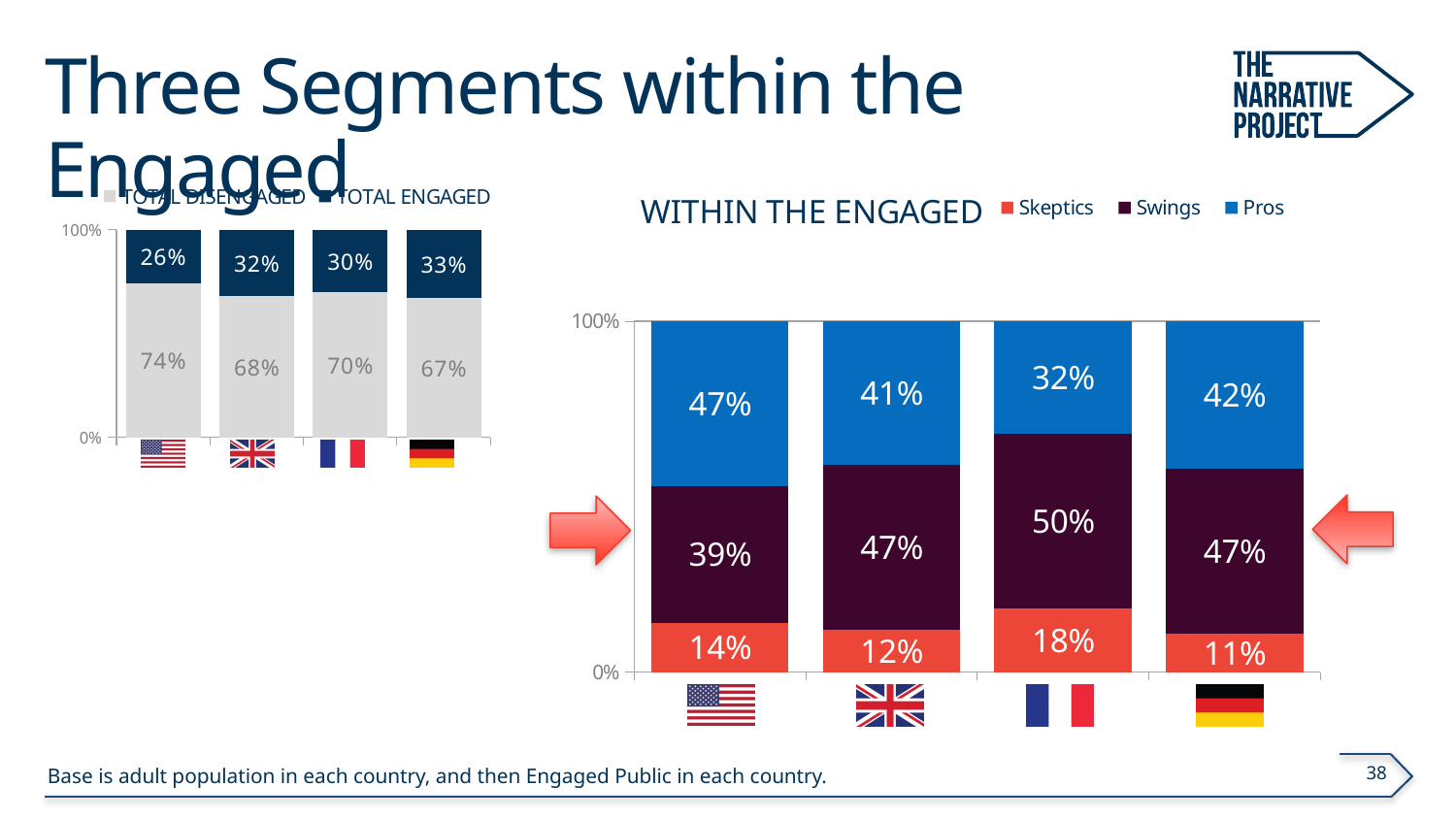
In the 'WITHIN THE ENGAGED' chart, what is the difference between the Pros values for the US and France bars? 15% In the left chart, which country's bar has the highest TOTAL DISENGAGED value? United States In the 'WITHIN THE ENGAGED' chart, what is the Skeptics value for the bar with the French flag? 18% In the 'WITHIN THE ENGAGED' chart, which country's bar has the lowest Skeptics value? Germany What kind of chart is the 'WITHIN THE ENGAGED' chart? Stacked bar chart In the left chart, what is the TOTAL ENGAGED value for the bar with the German flag? 33% In the 'WITHIN THE ENGAGED' chart, how many country bars are plotted? 4 In the 'WITHIN THE ENGAGED' chart, how many series does the legend list? 3 In the 'WITHIN THE ENGAGED' chart, what is the Swings value for the bar with the UK flag? 47% In the 'WITHIN THE ENGAGED' chart, which country's bar has the highest Swings value? France In the 'WITHIN THE ENGAGED' chart, what is the Pros value for the bar with the US flag? 47% In the left chart, is the TOTAL ENGAGED value for the UK bar larger or smaller than that for the France bar? Larger